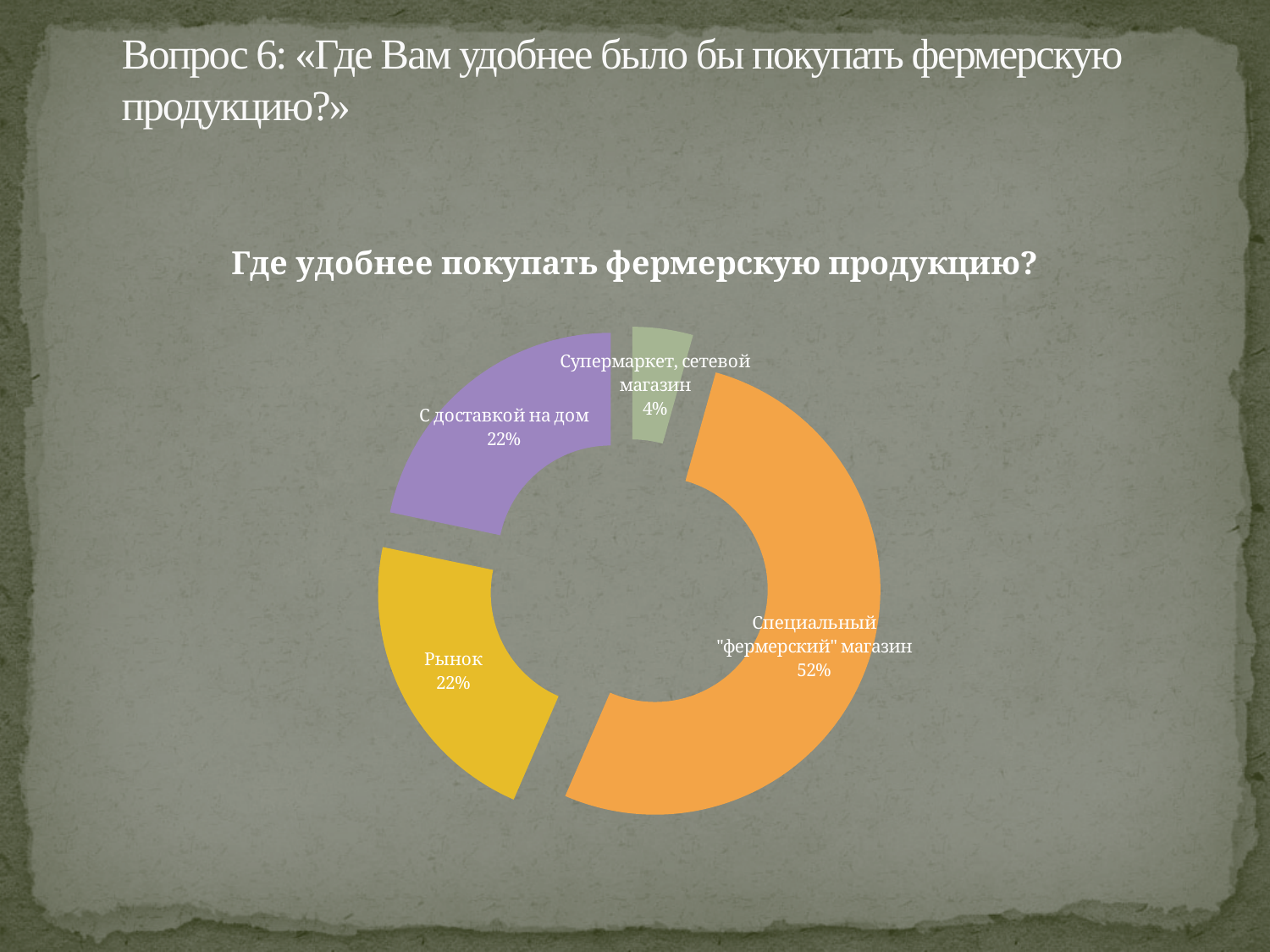
Which is larger, the share for Рынок or the share for Супермаркет, сетевой магазин? Рынок What is the difference between the shares of Специальный "фермерский" магазин and Рынок? 30% What is the difference between the shares of С доставкой на дом and Супермаркет, сетевой магазин? 18% What is the title of the chart? Где удобнее покупать фермерскую продукцию? What is the value for С доставкой на дом? 22% Which category has the smallest share? Супермаркет, сетевой магазин What share of the pie does Специальный "фермерский" магазин have? 52% What is the value for Супермаркет, сетевой магазин? 4% Which category has the largest share? Специальный "фермерский" магазин What kind of chart is shown on the slide? Pie chart (doughnut) What is the value for Рынок? 22% How many categories are shown in the chart? 4